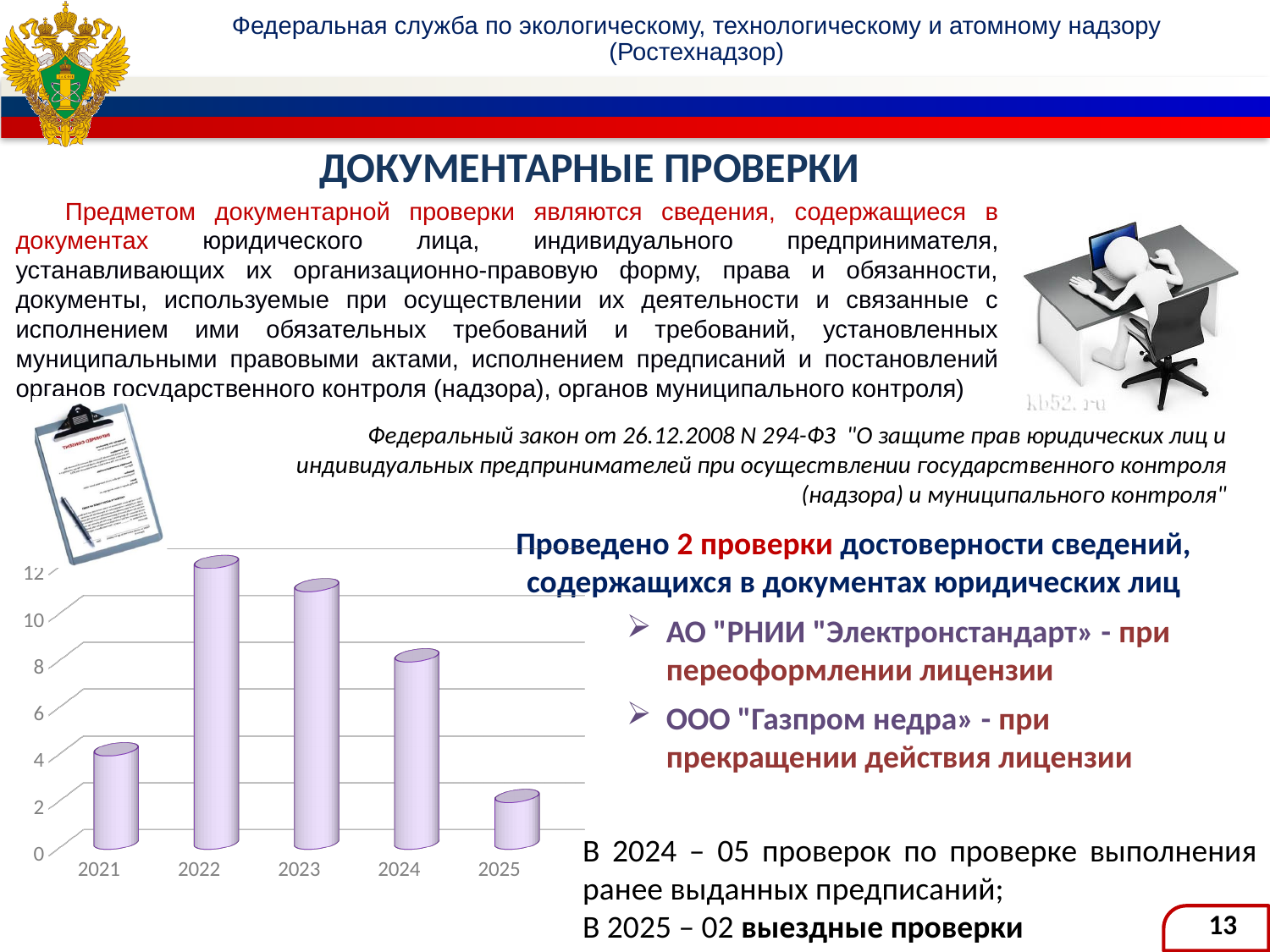
How many years are shown on the x axis of the chart? 5 Is the value for 2021 greater or less than 6? less Which is larger, the value for 2023 or the value for 2025? 2023 Do the values rise or fall from 2022 to 2025? fall Is the value for 2024 greater or less than 10? less Which year has the lowest bar in the chart? 2025 Is the value for 2025 greater or less than 4? less What is the highest tick value shown on the vertical axis of the chart? 12 Which is larger, the value for 2021 or the value for 2024? 2024 What kind of chart is shown on the slide? bar chart Which year has the highest bar in the chart? 2022